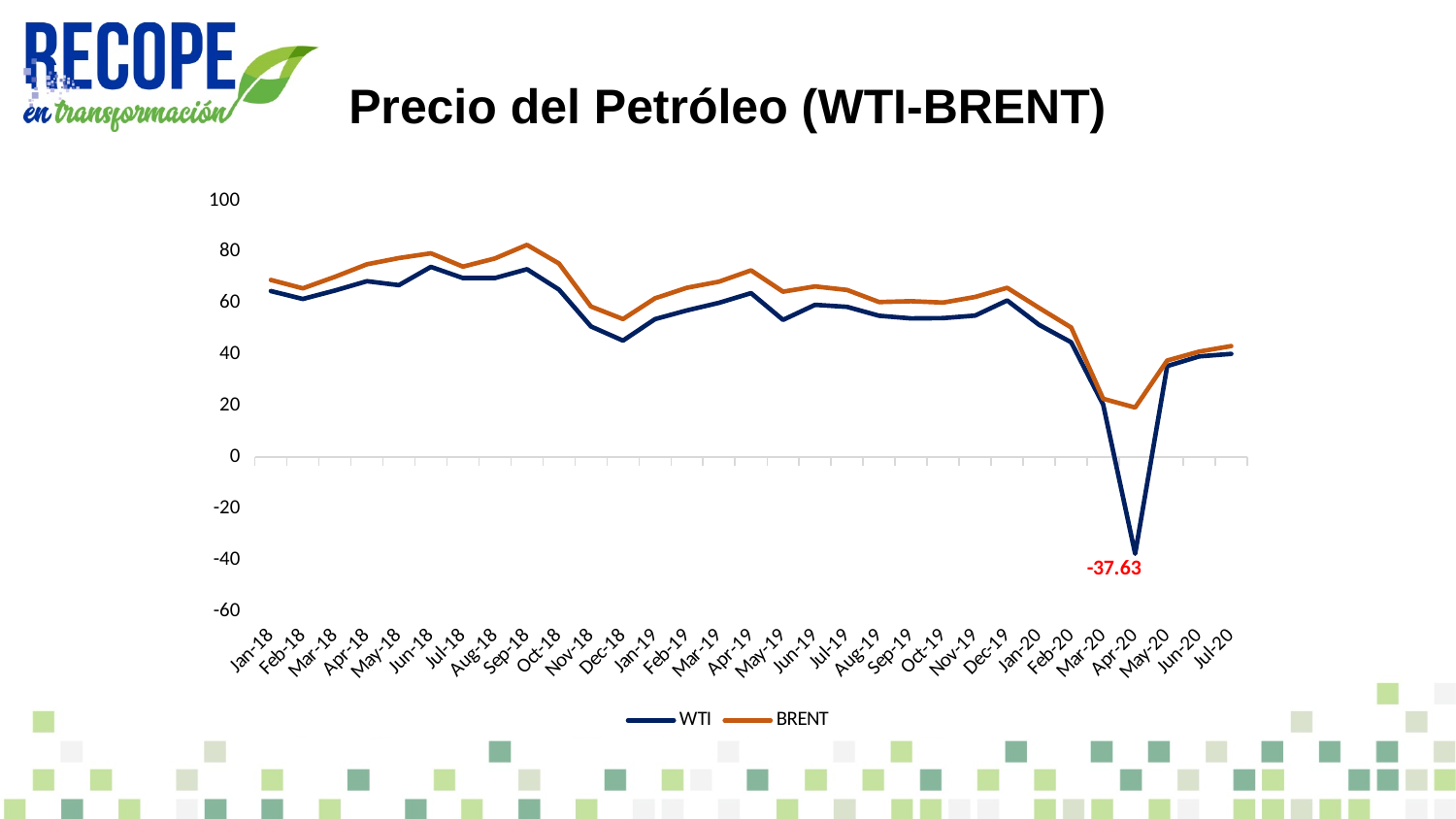
Is the WTI value for Dec-18 greater or less than 60? less At Sep-18, which series has the larger value, WTI or BRENT? BRENT What kind of chart is shown on the slide? line chart Does the BRENT series rise or fall between Apr-20 and Jul-20? rise Does the WTI series rise or fall between Dec-19 and Apr-20? fall Is the BRENT value for Sep-18 greater or less than 60? greater How many months are shown on the x axis? 31 What is the WTI value labelled at Apr-20? -37.63 In which month does the WTI series reach its lowest value? Apr-20 Is the BRENT value for Apr-20 greater or less than 40? less What is the title of the chart? Precio del Petróleo (WTI-BRENT) How many series does the legend list? 2